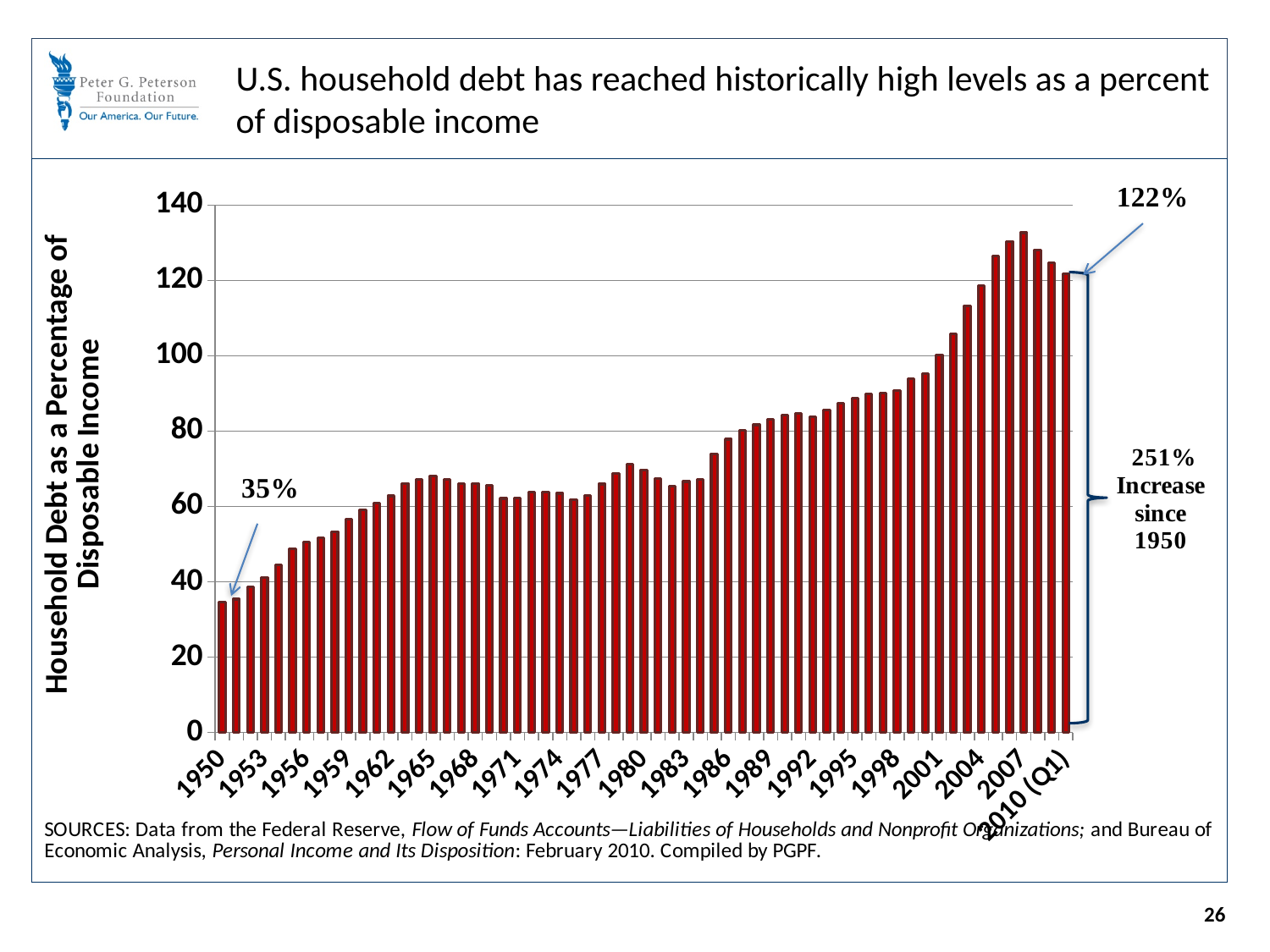
Which year has the lowest bar on the chart? 1950 By how many percentage points is the 2010 (Q1) value higher than the 1950 value, using the annotated values? 87 What kind of chart is shown on the slide? bar chart Which year has the highest bar on the chart? 2007 What is the value for 2010 (Q1) according to the annotation on the chart? 122% Is the value for 2007 greater or less than 120? greater Is the value for 1980 greater or less than 60? greater Is the value for 1956 greater or less than 60? less What is the value for 1950 according to the annotation on the chart? 35% Do the values generally rise or fall from 1950 to 2010 (Q1)? rise What percentage increase since 1950 does the annotation on the right of the chart state? 251% Which is larger, the value for 1995 or the value for 1977? 1995